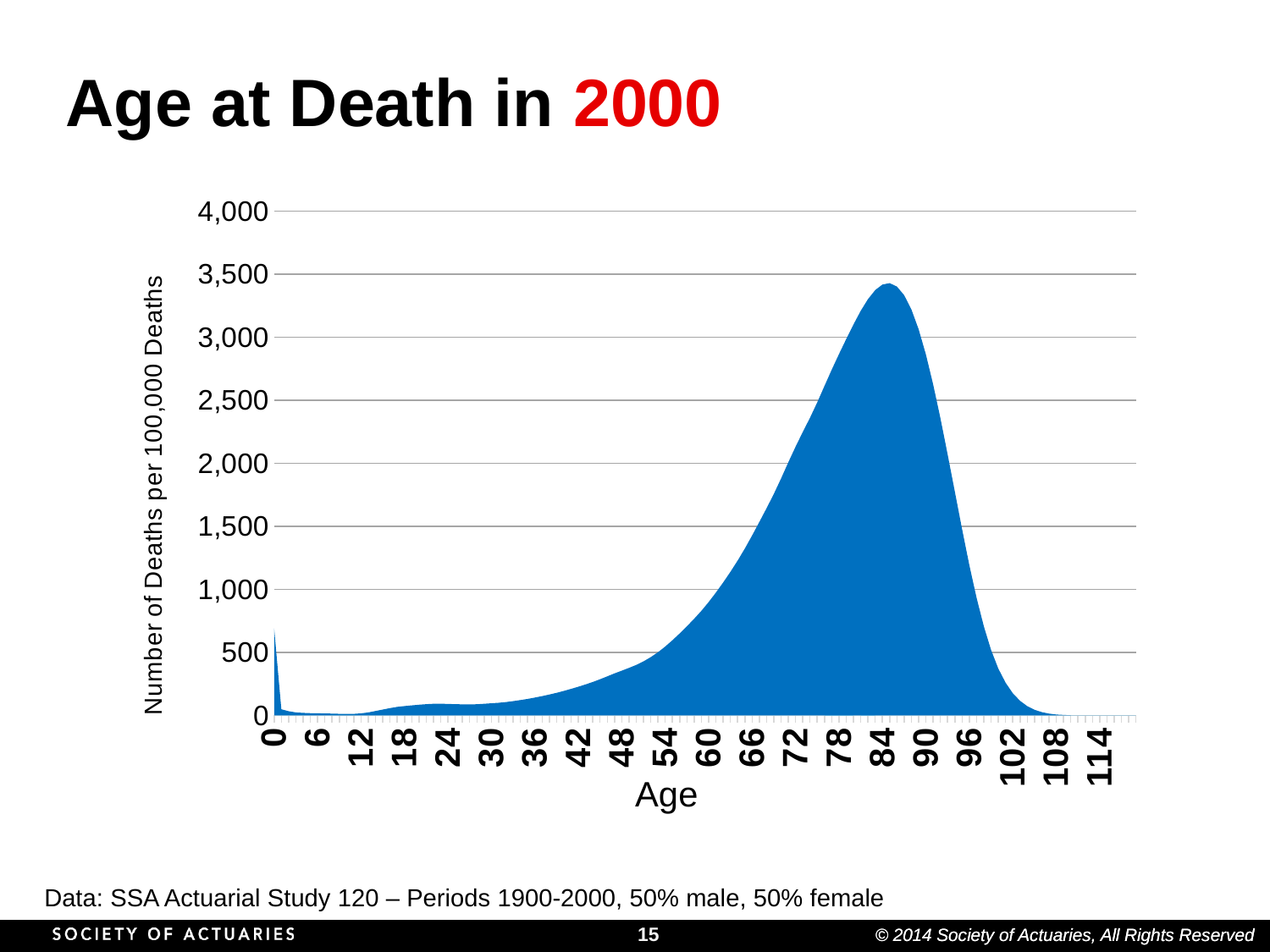
Is the peak value of the curve greater or less than 3,000? greater What kind of chart is shown on the slide? Area chart Is the peak value of the curve greater or less than 3,500? less Do the values rise or fall as age increases from 54 to 84? Rise Is the value at age 30 greater or less than 500? less What is the title of the chart on the slide? Age at Death in 2000 Do the values rise or fall as age increases from 90 to 108? Fall What is the label on the vertical axis of the chart? Number of Deaths per 100,000 Deaths Which has the larger value, age 78 or age 48? Age 78